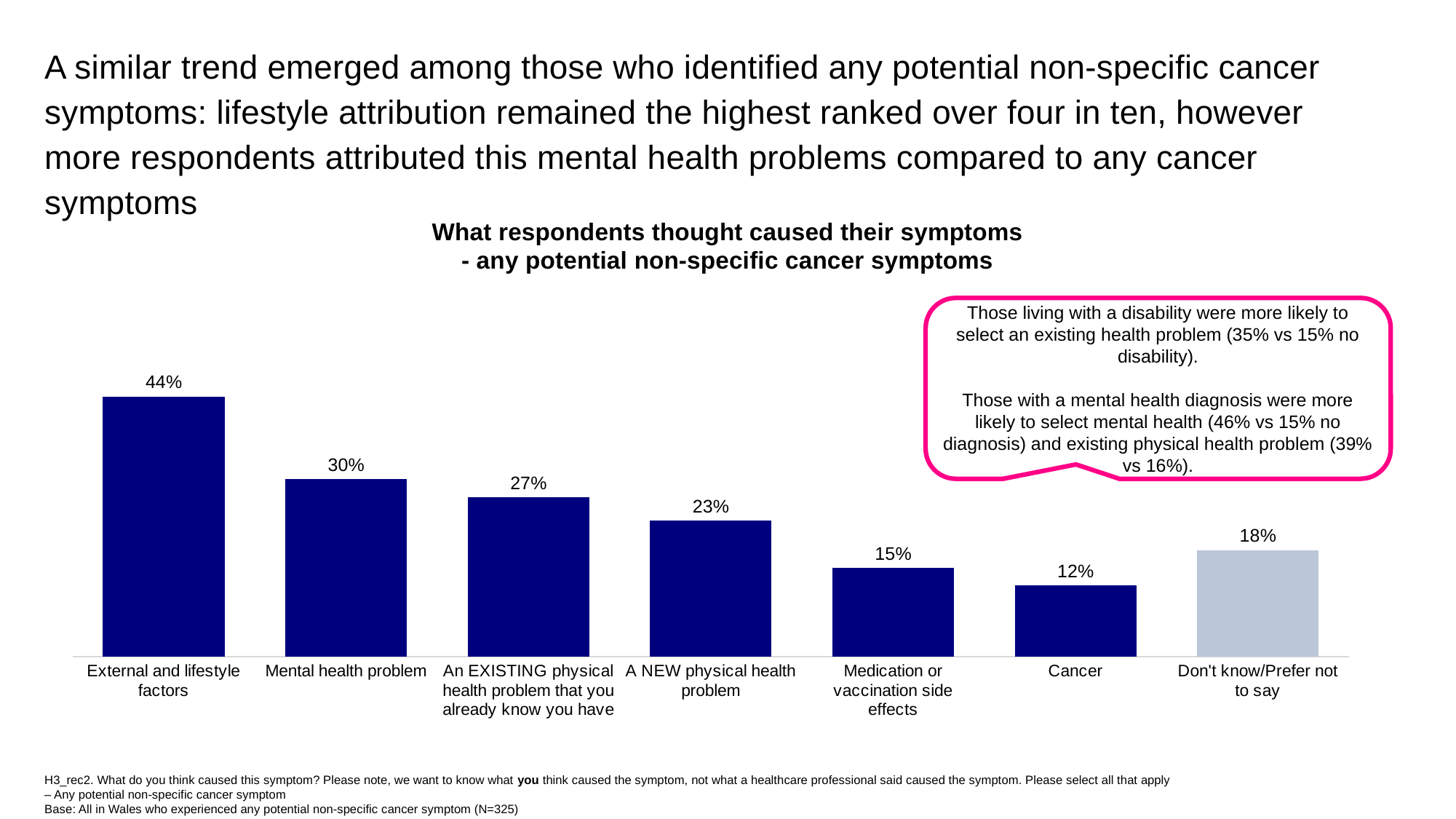
Which category has the lowest value? Cancer What is the difference between the values for External and lifestyle factors and Mental health problem? 14 percentage points What percentage of respondents attributed their symptoms to external and lifestyle factors? 44% What percentage of respondents selected Cancer as the cause of their symptoms? 12% What value is shown for Mental health problem? 30% What type of chart is shown on the slide? Bar chart How many categories are shown in the chart? 7 Which category has the highest value? External and lifestyle factors Which is larger: the value for An EXISTING physical health problem that you already know you have or the value for Don't know/Prefer not to say? An EXISTING physical health problem that you already know you have What is the difference between the values for A NEW physical health problem and Medication or vaccination side effects? 8 percentage points Which bar is shown in a different (light grey-blue) colour from the others? Don't know/Prefer not to say What value is shown for Don't know/Prefer not to say? 18%